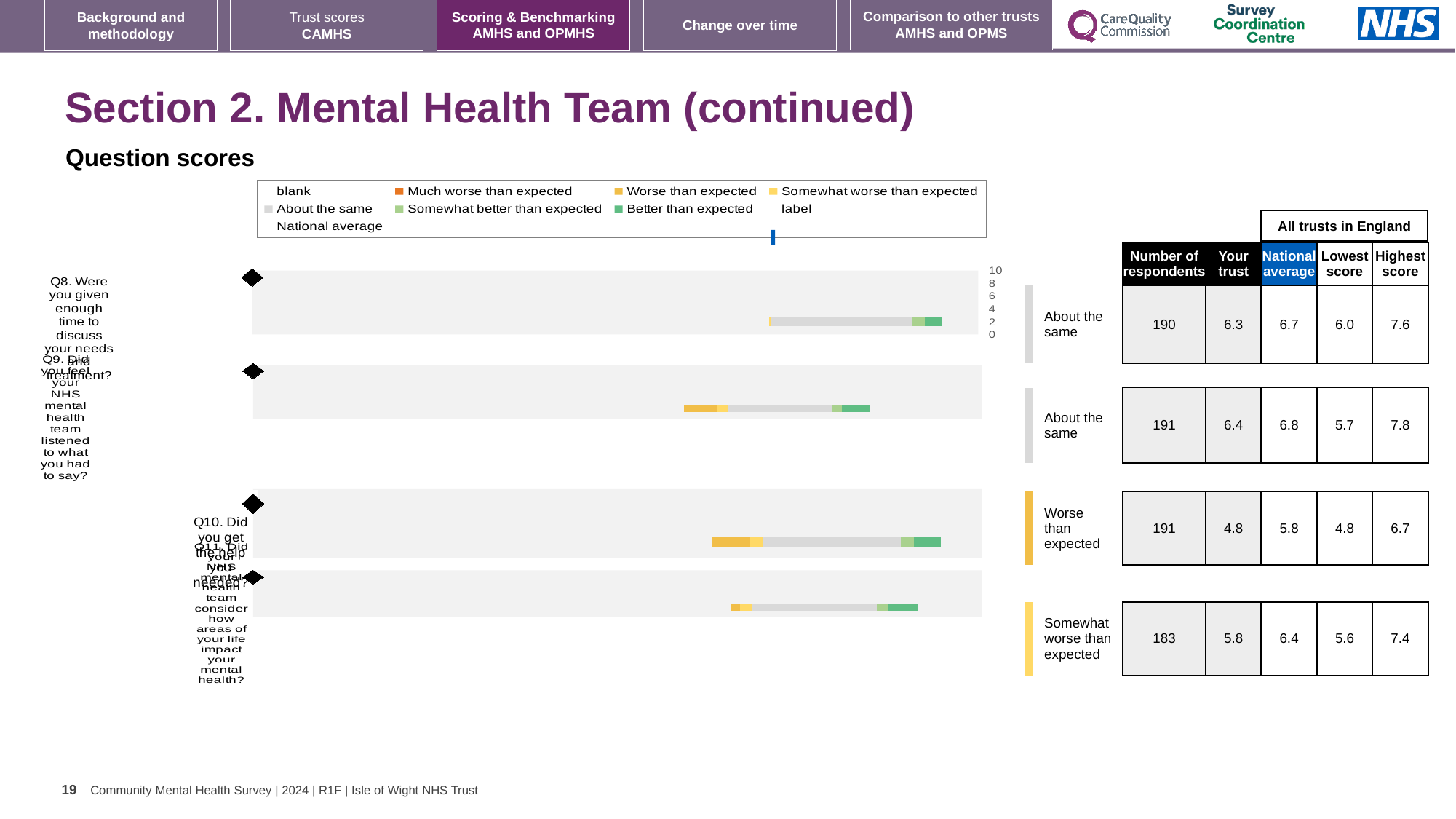
What is the national average score for Q9 in the table beside the chart? 6.8 What is the 'Your trust' score for Q10 in the table beside the chart? 4.8 How many questions (rows) are plotted in the question scores chart? 4 In the chart legend, which colour represents 'Much worse than expected'? orange According to the table beside the chart, how many respondents answered Q8? 190 What benchmark category is shown for Q10 next to the chart? Worse than expected For Q8, which is larger: the 'Your trust' score or the national average? national average What kind of chart is used to show the question scores on this slide? bar chart Which question has the lowest 'Your trust' score in the table beside the chart? Q10 Which question has the highest 'Your trust' score in the table beside the chart? Q9 What is the highest score across all trusts in England for Q11? 7.4 For Q10, what is the difference between the national average and the 'Your trust' score? 1.0